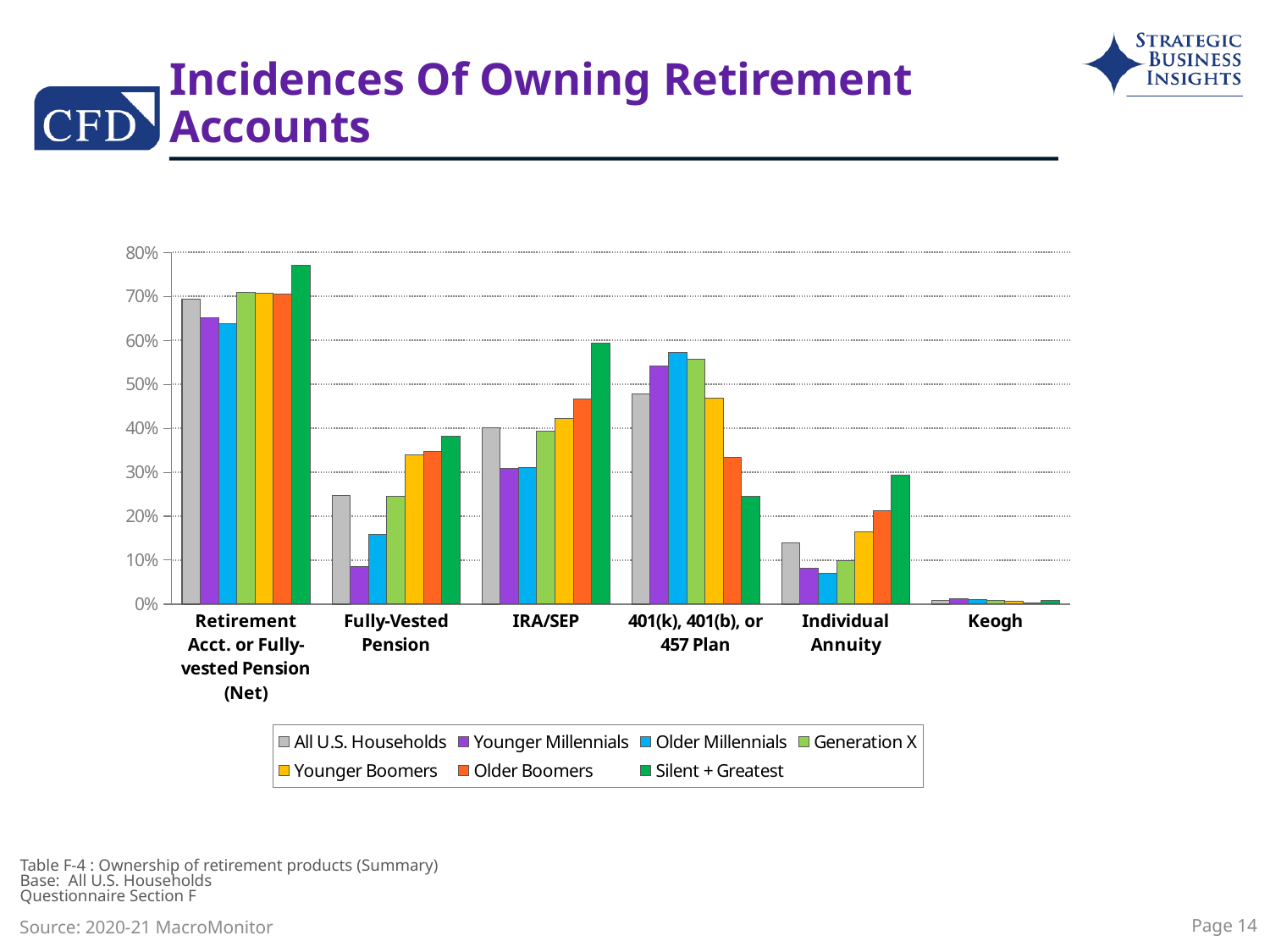
For Individual Annuity, which series has the highest value? Silent + Greatest Which category has the lowest values across all series? Keogh For 401(k), 401(b), or 457 Plan, which series has the lowest value? Silent + Greatest What kind of chart is shown on the slide? bar chart Is the value for Older Boomers in 401(k), 401(b), or 457 Plan greater or less than 40%? less For Retirement Acct. or Fully-vested Pension (Net), which series has the highest value? Silent + Greatest For Individual Annuity, which is larger: Older Boomers or Younger Millennials? Older Boomers How many retirement account categories are shown on the x axis? 6 How many series does the legend list? 7 For Fully-Vested Pension, which series has the lowest value? Younger Millennials For IRA/SEP, which series has the highest value? Silent + Greatest Is the value for Silent + Greatest in IRA/SEP greater or less than 50%? greater